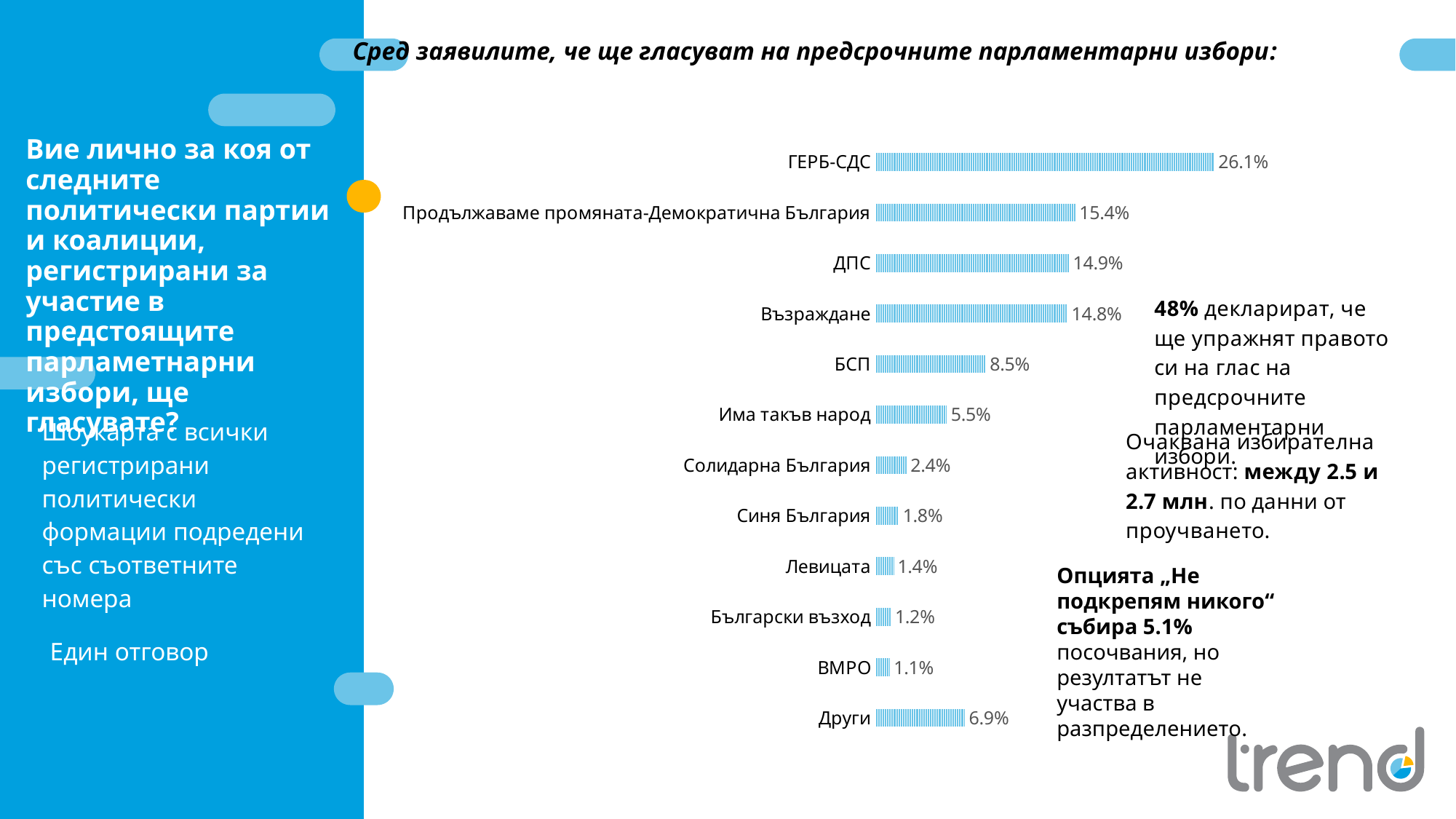
What is the value for Други? 6.9% What is the difference between the values for ГЕРБ-СДС and Продължаваме промяната-Демократична България? 10.7 percentage points What kind of chart is shown on the slide? bar chart What is the value for Възраждане? 14.8% Which category has the highest value? ГЕРБ-СДС What is the value for Има такъв народ? 5.5% What is the value for Продължаваме промяната-Демократична България? 15.4% Which category has the lowest value? ВМРО How many categories are shown in the chart? 12 What is the value for ГЕРБ-СДС? 26.1% Which has a larger value, ДПС or Възраждане? ДПС What is the title above the chart? Сред заявилите, че ще гласуват на предсрочните парламентарни избори: